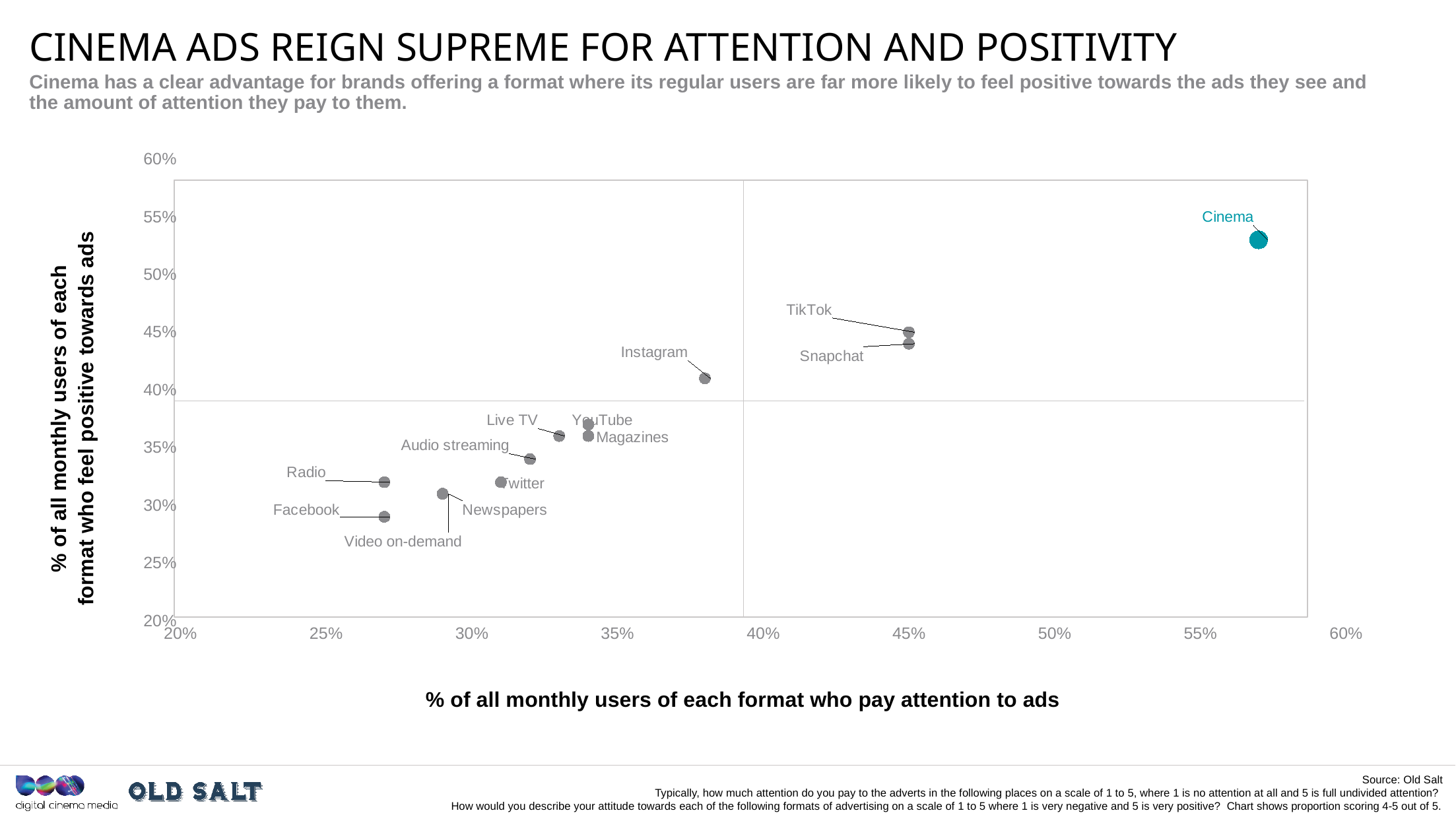
Is the percentage of TikTok users who pay attention to ads greater or less than 40%? greater Is the percentage of Cinema users who feel positive towards ads greater or less than 50%? greater Which format has the lowest percentage of monthly users who feel positive towards ads? Facebook Which format has the highest percentage of monthly users who feel positive towards ads? Cinema Is the percentage of Cinema users who pay attention to ads greater or less than 55%? greater Which format has a higher percentage of users who pay attention to ads, TikTok or Instagram? TikTok What kind of chart is shown on the slide? Scatter chart How many formats are labelled on the chart? 13 Which format has a higher percentage of users who feel positive towards ads, Cinema or Snapchat? Cinema What is the title of the horizontal axis? % of all monthly users of each format who pay attention to ads Which format has the highest percentage of monthly users who pay attention to ads? Cinema